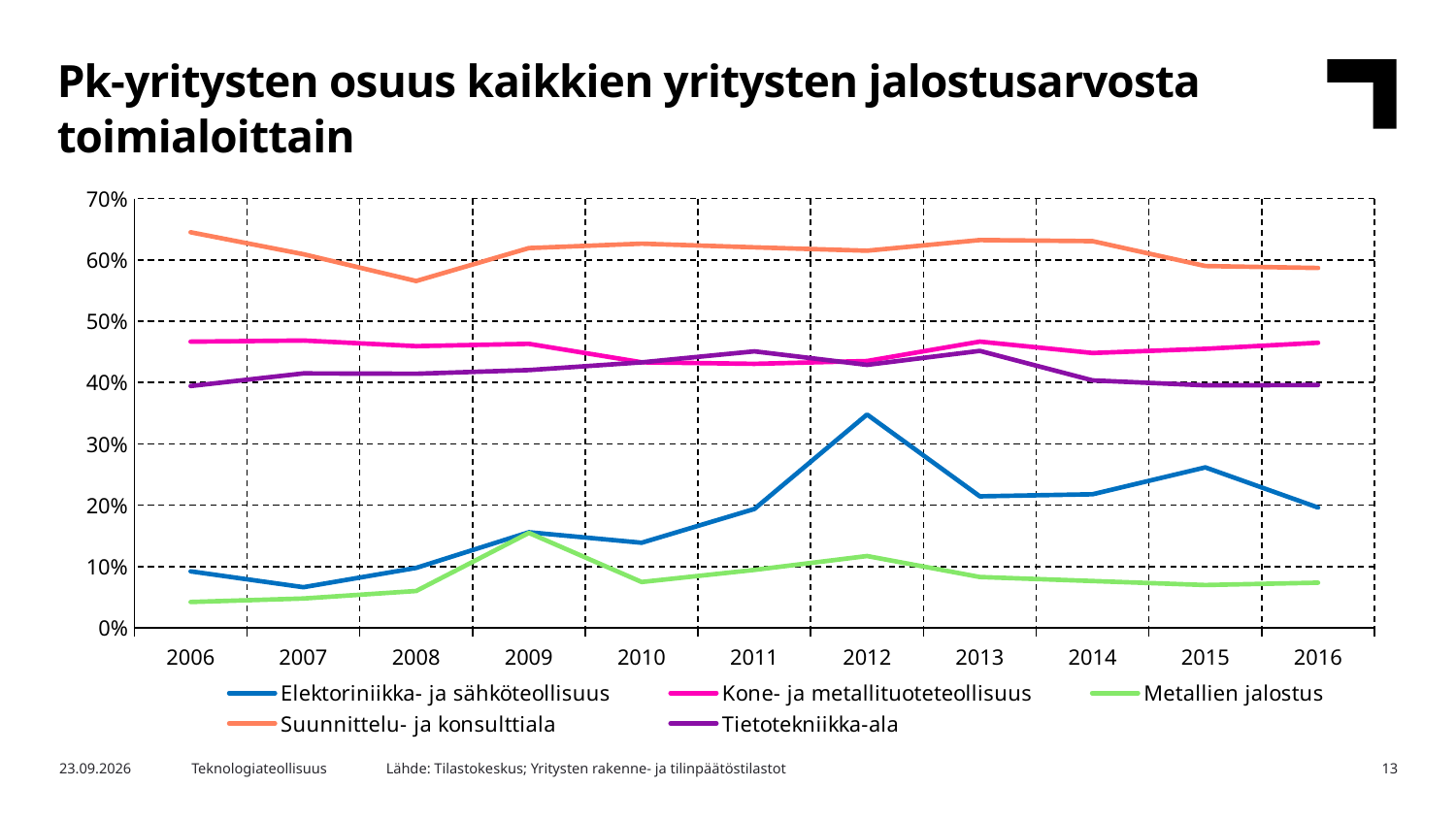
How many series does the legend list? 5 Is the value for Metallien jalostus in 2006 greater or less than 10%? less Which series has the lowest value in 2016? Metallien jalostus Is the value for Suunnittelu- ja konsulttiala in 2006 greater or less than 60%? greater In which year does Elektoriniikka- ja sähköteollisuus reach its highest value? 2012 For Elektoriniikka- ja sähköteollisuus, which year has the larger value, 2012 or 2016? 2012 How many years are shown on the x axis? 11 Which series has the highest value in 2016? Suunnittelu- ja konsulttiala Is the value for Elektoriniikka- ja sähköteollisuus in 2012 greater or less than 30%? greater What kind of chart is shown on the slide? line chart Does the value for Suunnittelu- ja konsulttiala rise or fall from 2006 to 2008? fall